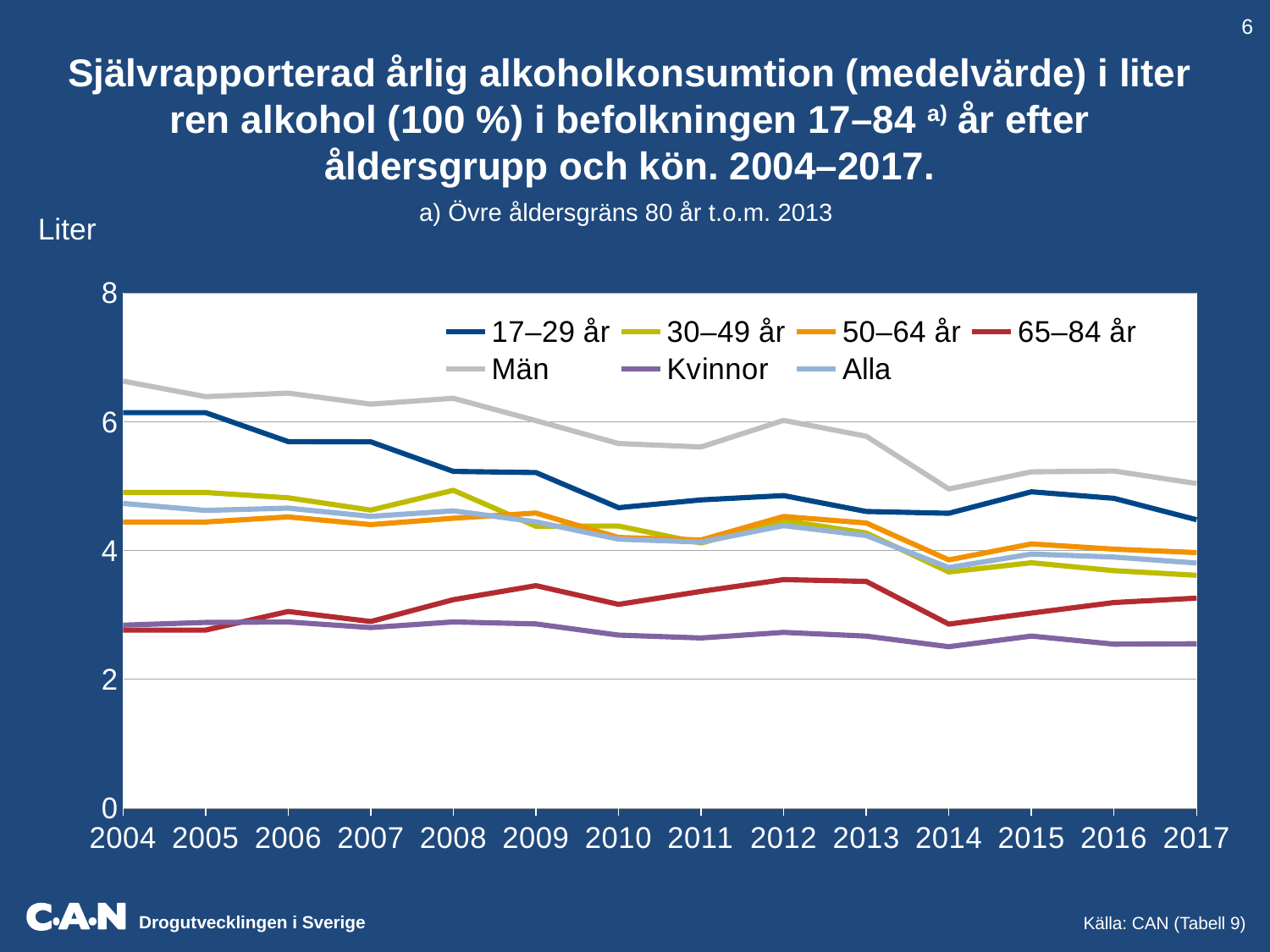
What kind of chart is shown on the slide? line chart Which series has the highest value in 2004? Män Is the value for 65–84 år in 2004 greater or less than 4? less Which is larger in 2010, the value for Män or the value for Kvinnor? Män Is the value for Kvinnor in 2017 greater or less than 4? less How many series does the legend list? 7 Which series has the lowest value in 2017? Kvinnor How many years are shown along the x axis? 14 What is the label on the y axis? Liter Does the value for 17–29 år rise or fall from 2004 to 2017? fall Is the value for Män in 2004 greater or less than 6? greater What source is cited for the chart? CAN (Tabell 9)